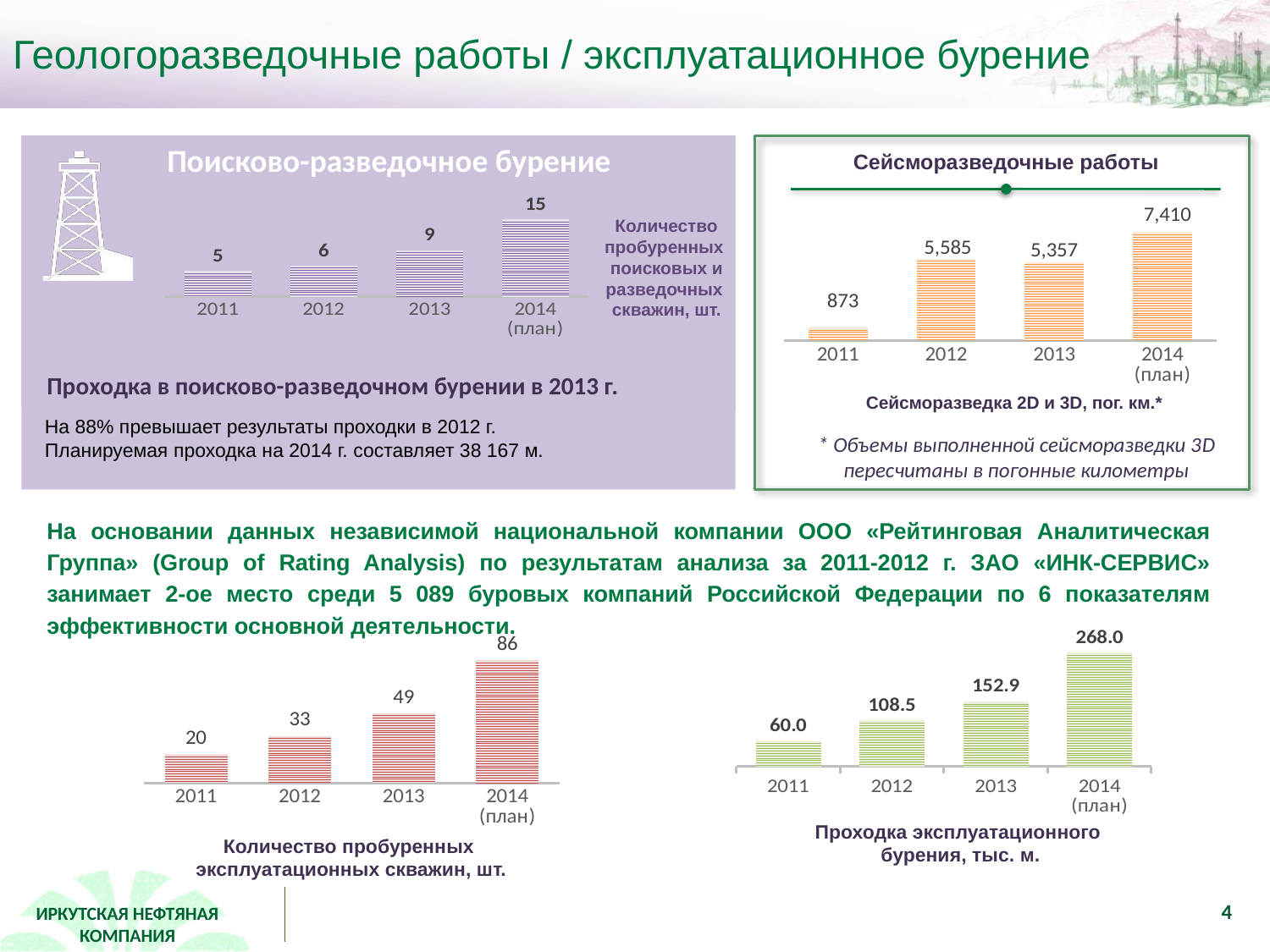
In the 'Сейсморазведочные работы' chart (top right), which is larger, the value for 2012 or the value for 2013? 2012 In the 'Сейсморазведочные работы' chart (top right), what is the value for 2012? 5,585 In the 'Проходка эксплуатационного бурения, тыс. м.' chart (bottom right), what is the value for 2013? 152.9 In the 'Поисково-разведочное бурение' chart (top left), what is the value for 2013? 9 What kind of chart is the 'Проходка эксплуатационного бурения, тыс. м.' chart (bottom right)? bar chart In the 'Поисково-разведочное бурение' chart (top left), which year has the highest value? 2014 (план) In the 'Количество пробуренных эксплуатационных скважин, шт.' chart (bottom left), what is the value for 2012? 33 In the 'Сейсморазведочные работы' chart (top right), what is the difference between the 2014 (план) value and the 2013 value? 2,053 In the 'Количество пробуренных эксплуатационных скважин, шт.' chart (bottom left), how many years are shown on the x axis? 4 In the 'Сейсморазведочные работы' chart (top right), which year has the lowest value? 2011 In the 'Количество пробуренных эксплуатационных скважин, шт.' chart (bottom left), what is the difference between the 2014 (план) value and the 2013 value? 37 In the 'Проходка эксплуатационного бурения, тыс. м.' chart (bottom right), do the values rise or fall from 2011 to 2014 (план)? rise